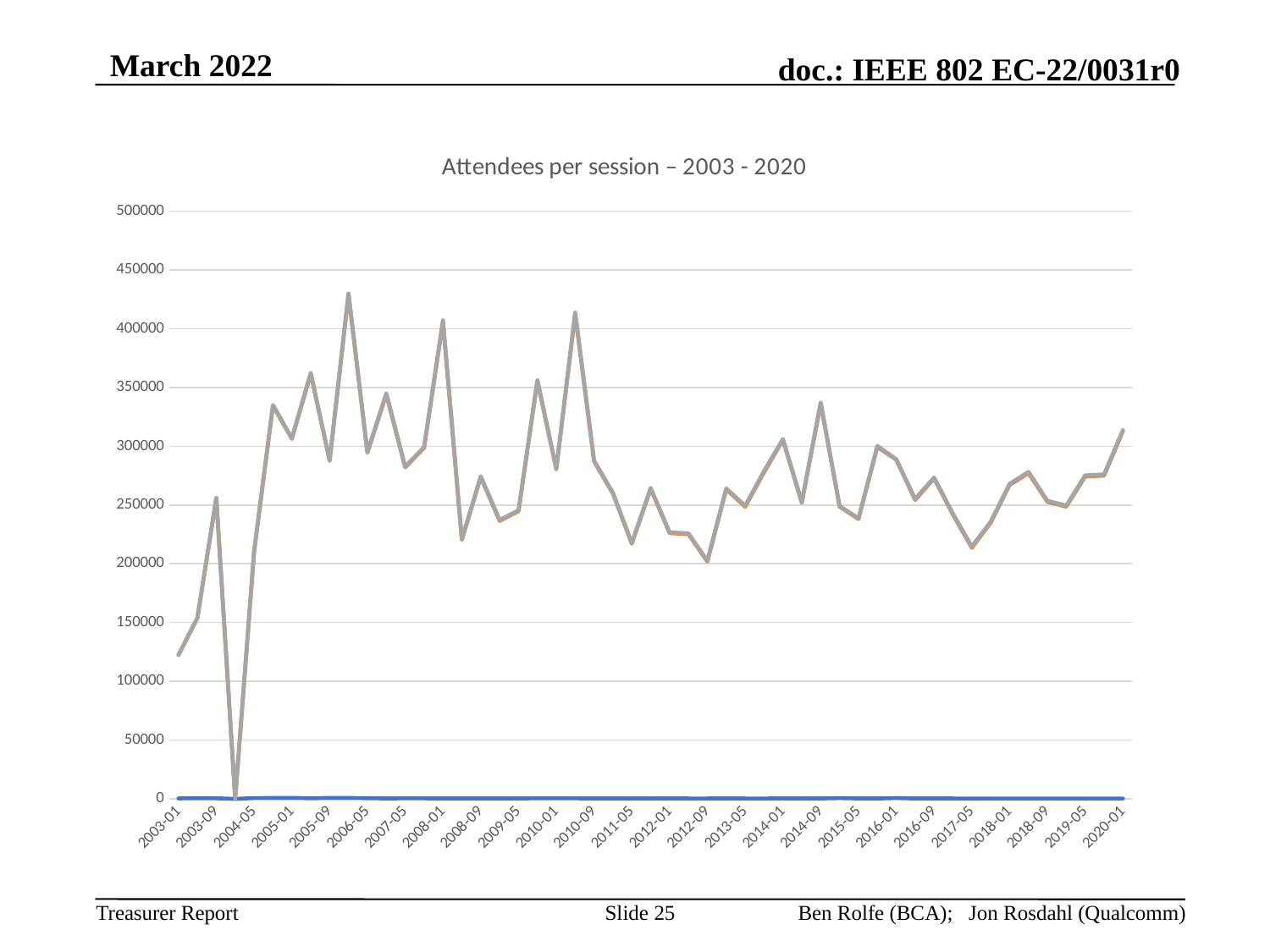
Does the line rise or fall between 2003-01 and 2003-09? rise What is the title of the chart? Attendees per session – 2003 - 2020 Is the value for 2017-05 greater or less than 250000? less Is the value for 2008-01 greater or less than 350000? greater Is the value for 2003-01 greater or less than 150000? less What kind of chart is shown on the slide? line chart Which has more attendees, 2008-01 or 2003-01? 2008-01 Which labelled session has the lowest number of attendees? 2003-01